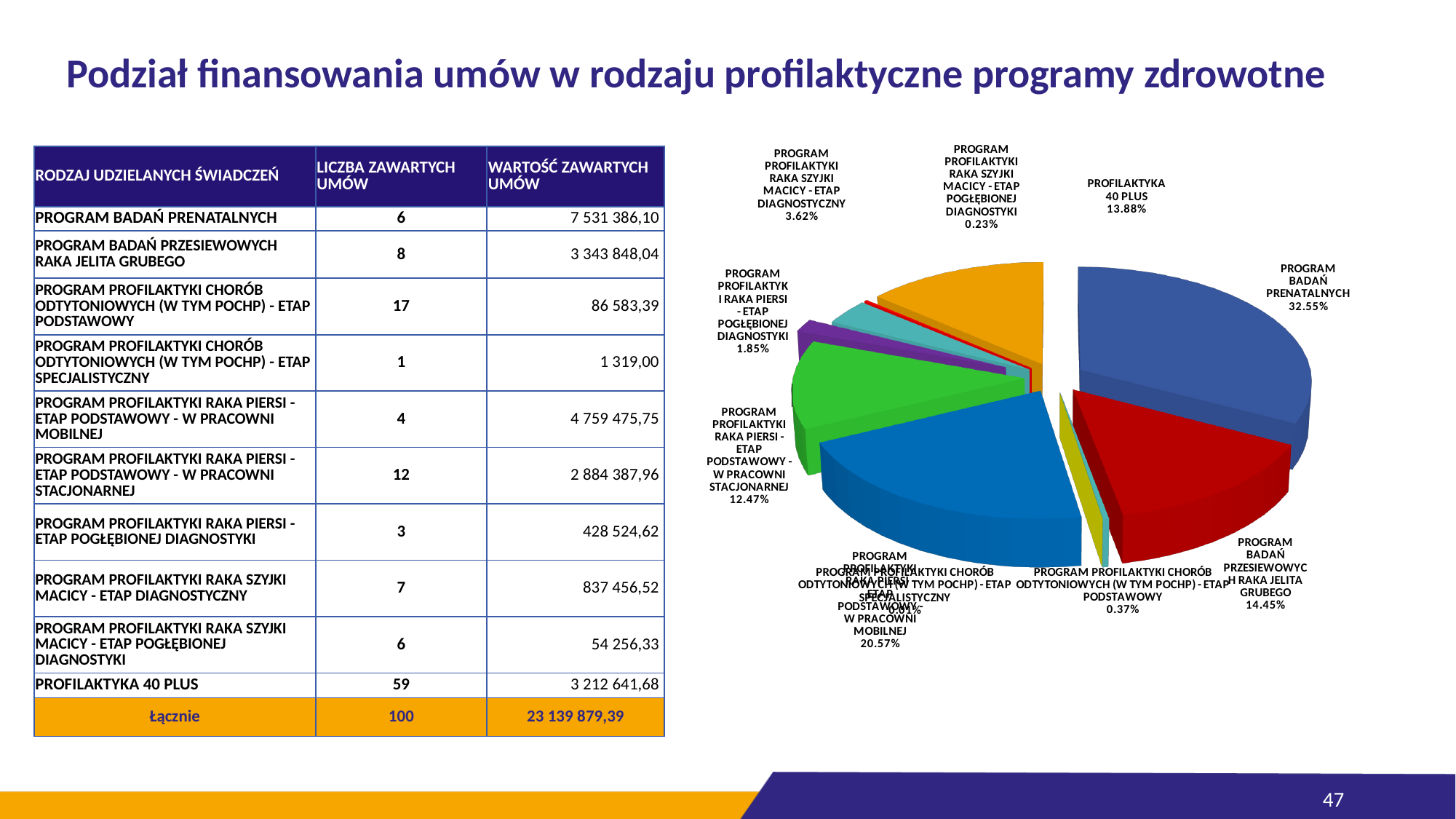
What percentage is shown for PROGRAM BADAŃ PRZESIEWOWYCH RAKA JELITA GRUBEGO in the pie chart? 14.45% What is the difference in percentage points between the RAKA PIERSI ETAP PODSTAWOWY slices for W PRACOWNI MOBILNEJ and W PRACOWNI STACJONARNEJ? 8.10% Which slice is larger: PROFILAKTYKA 40 PLUS or PROGRAM BADAŃ PRZESIEWOWYCH RAKA JELITA GRUBEGO? PROGRAM BADAŃ PRZESIEWOWYCH RAKA JELITA GRUBEGO What percentage is shown for PROGRAM PROFILAKTYKI RAKA PIERSI - ETAP POGŁĘBIONEJ DIAGNOSTYKI? 1.85% What percentage is shown for PROGRAM PROFILAKTYKI RAKA SZYJKI MACICY - ETAP DIAGNOSTYCZNY? 3.62% Which category has the largest slice of the pie chart? PROGRAM BADAŃ PRENATALNYCH How many slices does the pie chart have? 10 What percentage is shown for PROGRAM PROFILAKTYKI RAKA PIERSI - ETAP PODSTAWOWY - W PRACOWNI STACJONARNEJ? 12.47% What percentage is shown for PROFILAKTYKA 40 PLUS in the pie chart? 13.88% What share of the pie does PROGRAM BADAŃ PRENATALNYCH have? 32.55% What is the difference in percentage points between PROGRAM BADAŃ PRENATALNYCH and PROGRAM BADAŃ PRZESIEWOWYCH RAKA JELITA GRUBEGO? 18.10% What kind of chart is shown on the slide? pie chart